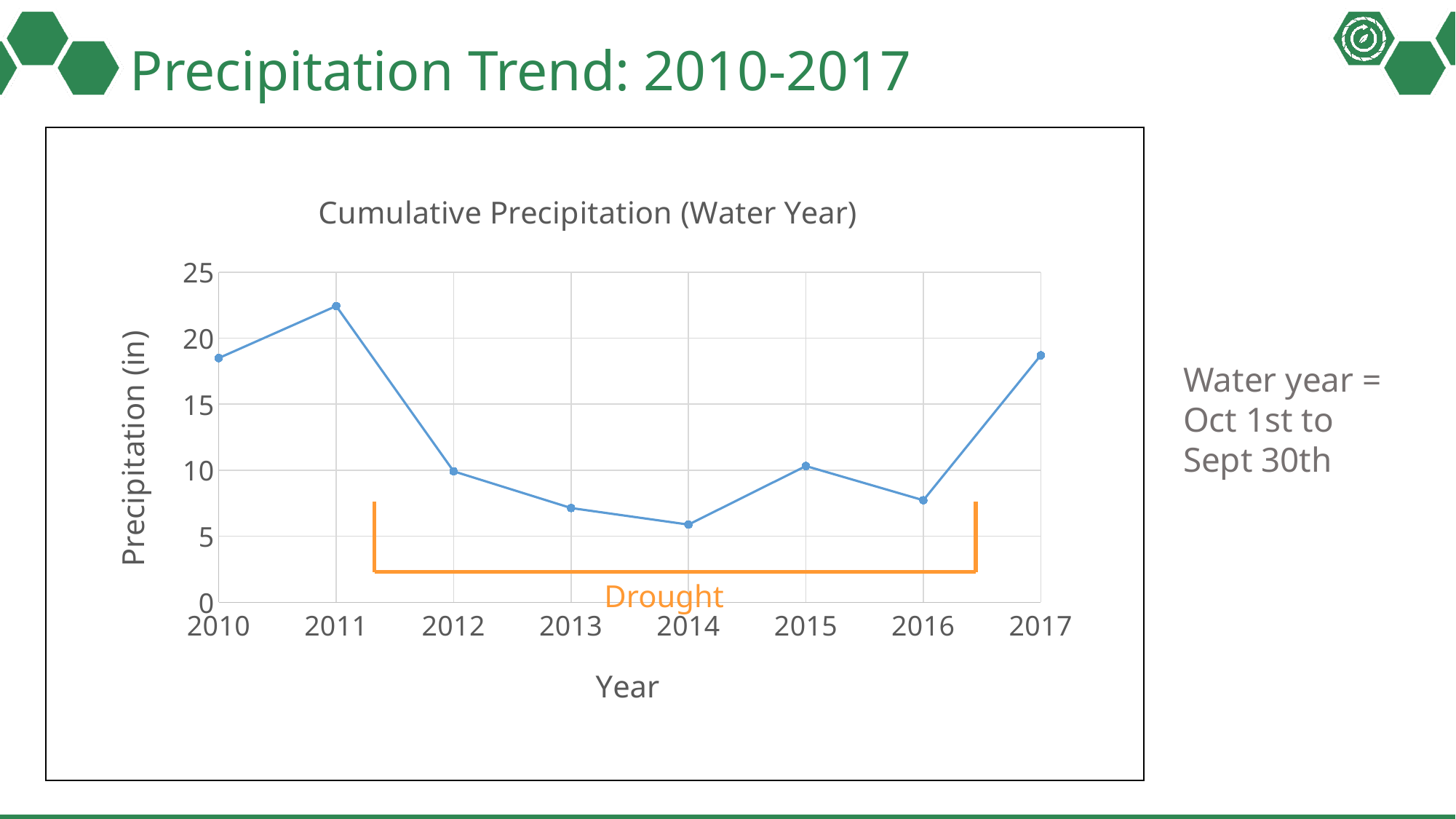
Is the precipitation value for 2011 greater or less than 20? greater What is the title of the chart? Cumulative Precipitation (Water Year) What kind of chart is shown on the slide? line chart Is the precipitation value for 2014 greater or less than 5? greater Is the precipitation value for 2016 greater or less than 10? less Which year has higher precipitation, 2010 or 2011? 2011 Does the precipitation rise or fall from 2011 to 2014? fall Which year has the highest cumulative precipitation? 2011 Which year has the lowest cumulative precipitation? 2014 How many years (data points) are plotted on the chart? 8 What label is written on the orange bracket under the chart? Drought